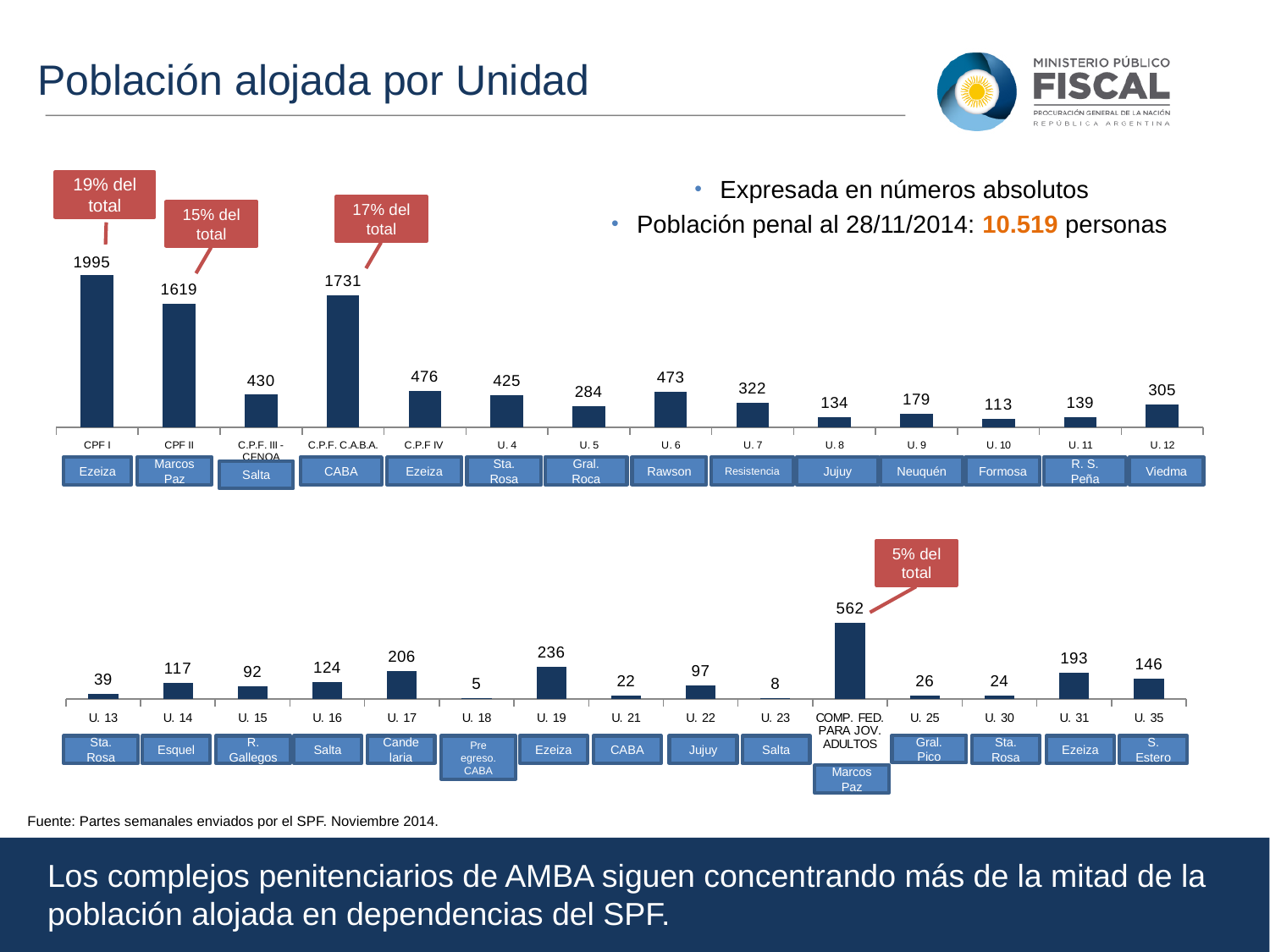
In the top chart, which is larger, the value for C.P.F IV or the value for U. 4? C.P.F IV In the top chart, what is the value for U. 6? 473 In the top chart, what is the difference between the values for CPF I and CPF II? 376 How many units are shown in the top chart? 14 In the bottom chart, which unit has the highest value? COMP. FED. PARA JOV. ADULTOS In the bottom chart, what is the value for U. 19? 236 In the top chart, which unit has the lowest value? U. 10 What type of chart is used on this slide? Bar chart In the bottom chart, which unit has the lowest value? U. 18 In the top chart, what is the value for CPF I? 1995 In the top chart, which unit has the highest value? CPF I How many units are shown in the bottom chart? 15